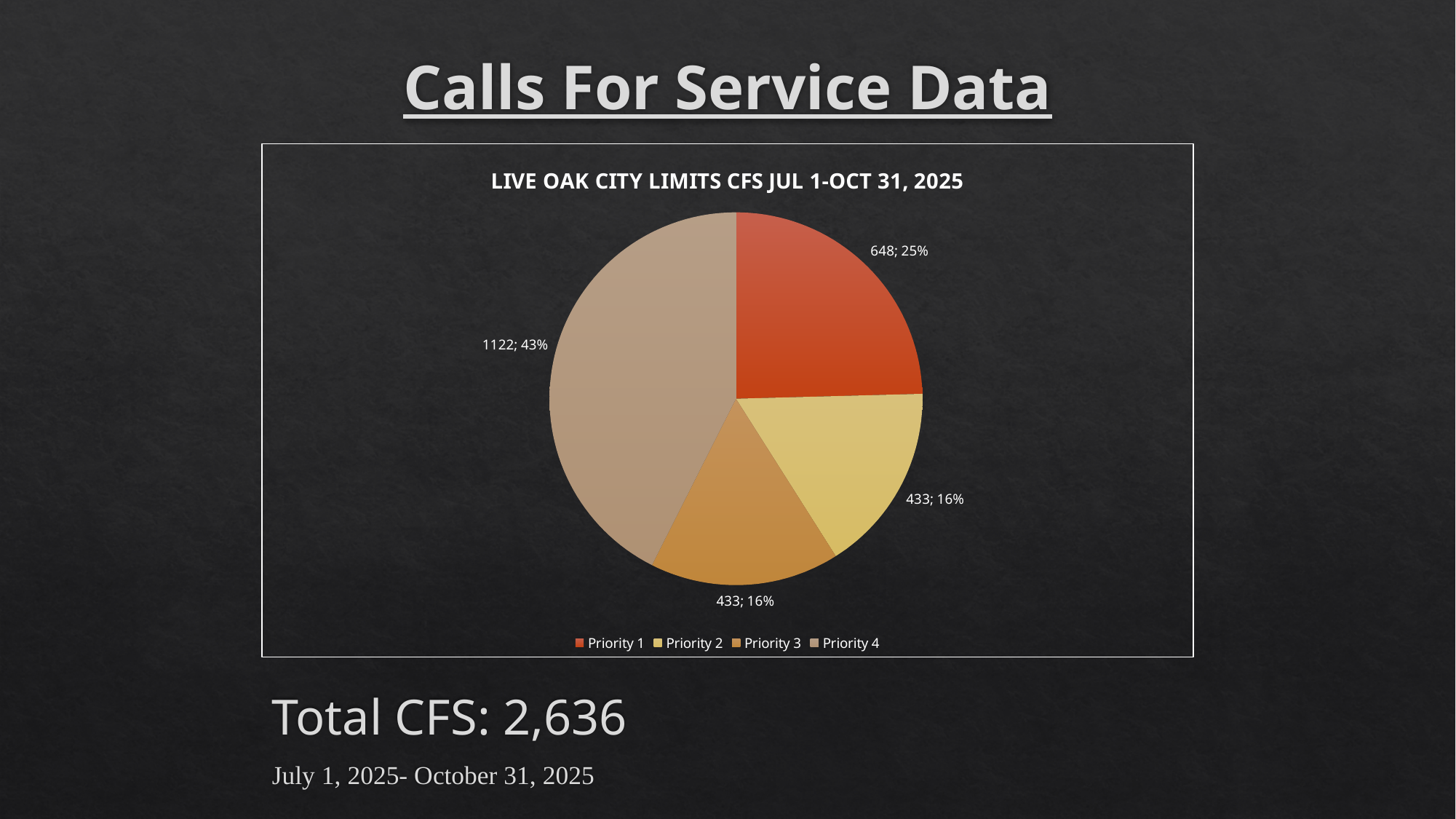
What percentage share of the pie does Priority 4 represent? 43% Which is larger, the value for Priority 1 or the value for Priority 3? Priority 1 How many categories does the legend list? 4 How many calls for service are shown for Priority 4? 1122 How many calls for service are shown for Priority 2? 433 What percentage share of the pie does Priority 1 represent? 25% Which priority category has the largest slice of the pie? Priority 4 What type of chart is shown on the slide? Pie chart What is the title of the chart? LIVE OAK CITY LIMITS CFS JUL 1-OCT 31, 2025 How many calls for service are shown for Priority 1? 648 What is the total number of calls for service stated on the slide? 2,636 What is the difference between the Priority 4 value and the Priority 1 value? 474